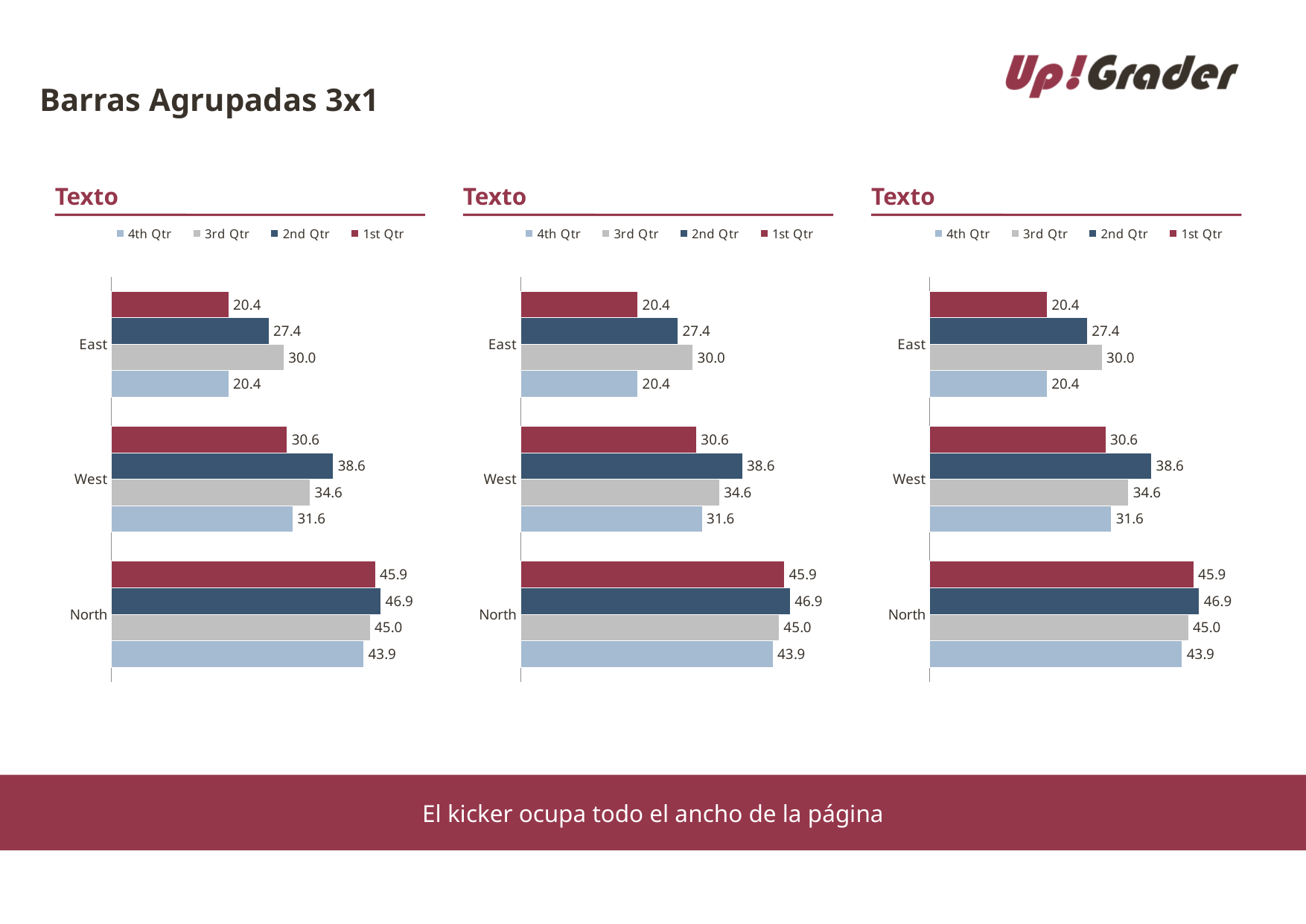
In the middle chart, what is the difference between the 2nd Qtr values for North and West? 8.3 In the left chart, what is the value for 2nd Qtr in the West category? 38.6 In the right chart, what is the difference between the 2nd Qtr and 1st Qtr values for East? 7.0 In the left chart, which category has the highest 1st Qtr value? North What type of chart is the left chart? Bar chart In the right chart, what is the value for 4th Qtr in the North category? 43.9 What is the title of the right chart? Texto In the left chart, which is larger for North: the 3rd Qtr value or the 4th Qtr value? 3rd Qtr How many categories are shown on the y axis of the middle chart? 3 How many series does the legend of the right chart list? 4 In the middle chart, which quarter has the lowest value in the West category? 1st Qtr In the middle chart, what is the value for 3rd Qtr in the East category? 30.0